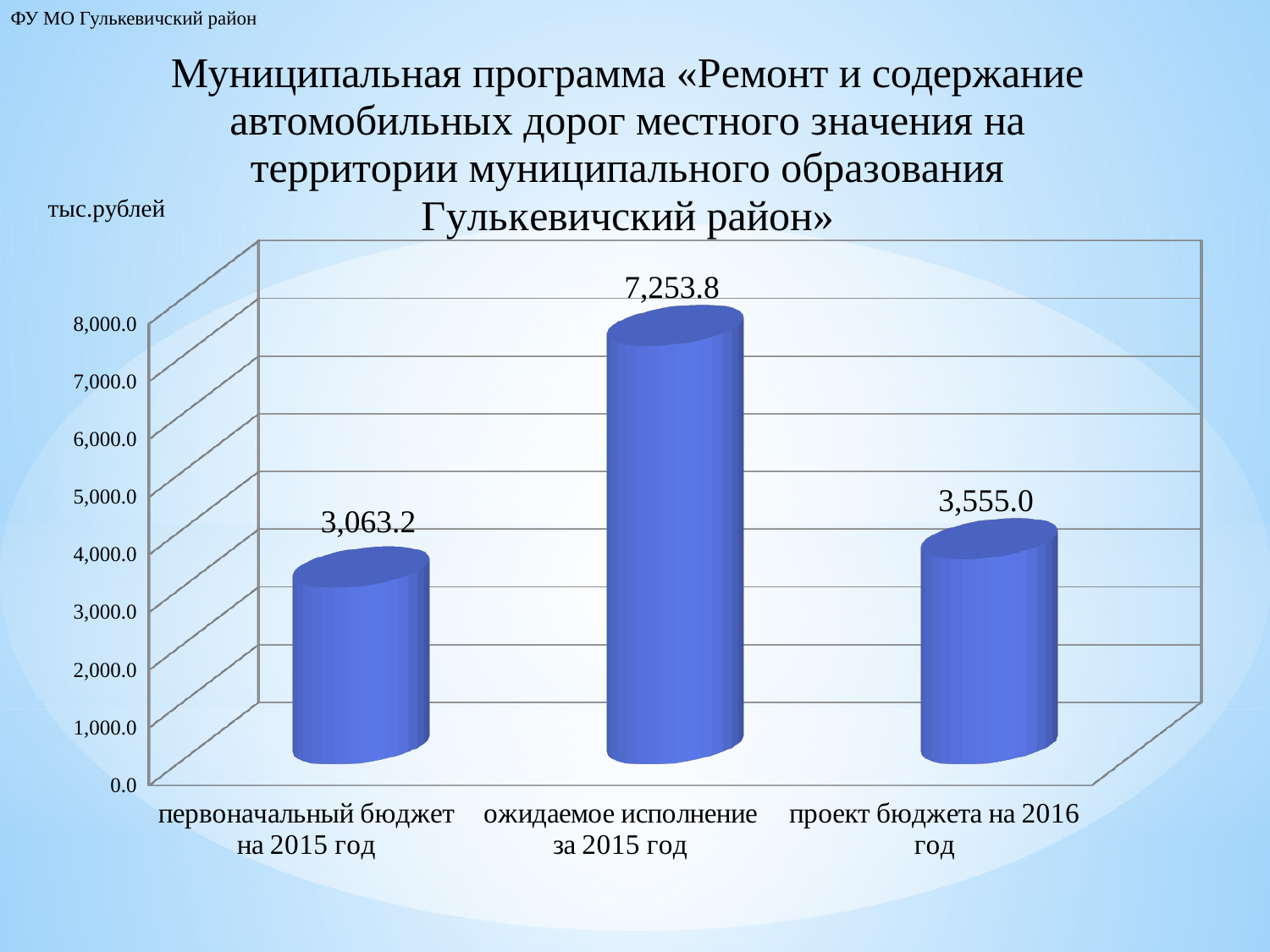
Which is larger: «проект бюджета на 2016 год» or «первоначальный бюджет на 2015 год»? проект бюджета на 2016 год Which category has the highest value? ожидаемое исполнение за 2015 год What is the value for «первоначальный бюджет на 2015 год»? 3,063.2 What is the difference between «проект бюджета на 2016 год» and «первоначальный бюджет на 2015 год»? 491.8 What is the value for «проект бюджета на 2016 год»? 3,555.0 Is the value for «ожидаемое исполнение за 2015 год» greater or less than 7,000.0? greater How many categories are shown on the chart? 3 Which category has the lowest value? первоначальный бюджет на 2015 год What kind of chart is shown on the slide? bar chart What unit of measurement is indicated for the chart values? тыс.рублей What is the difference between «ожидаемое исполнение за 2015 год» and «первоначальный бюджет на 2015 год»? 4,190.6 What is the value for «ожидаемое исполнение за 2015 год»? 7,253.8